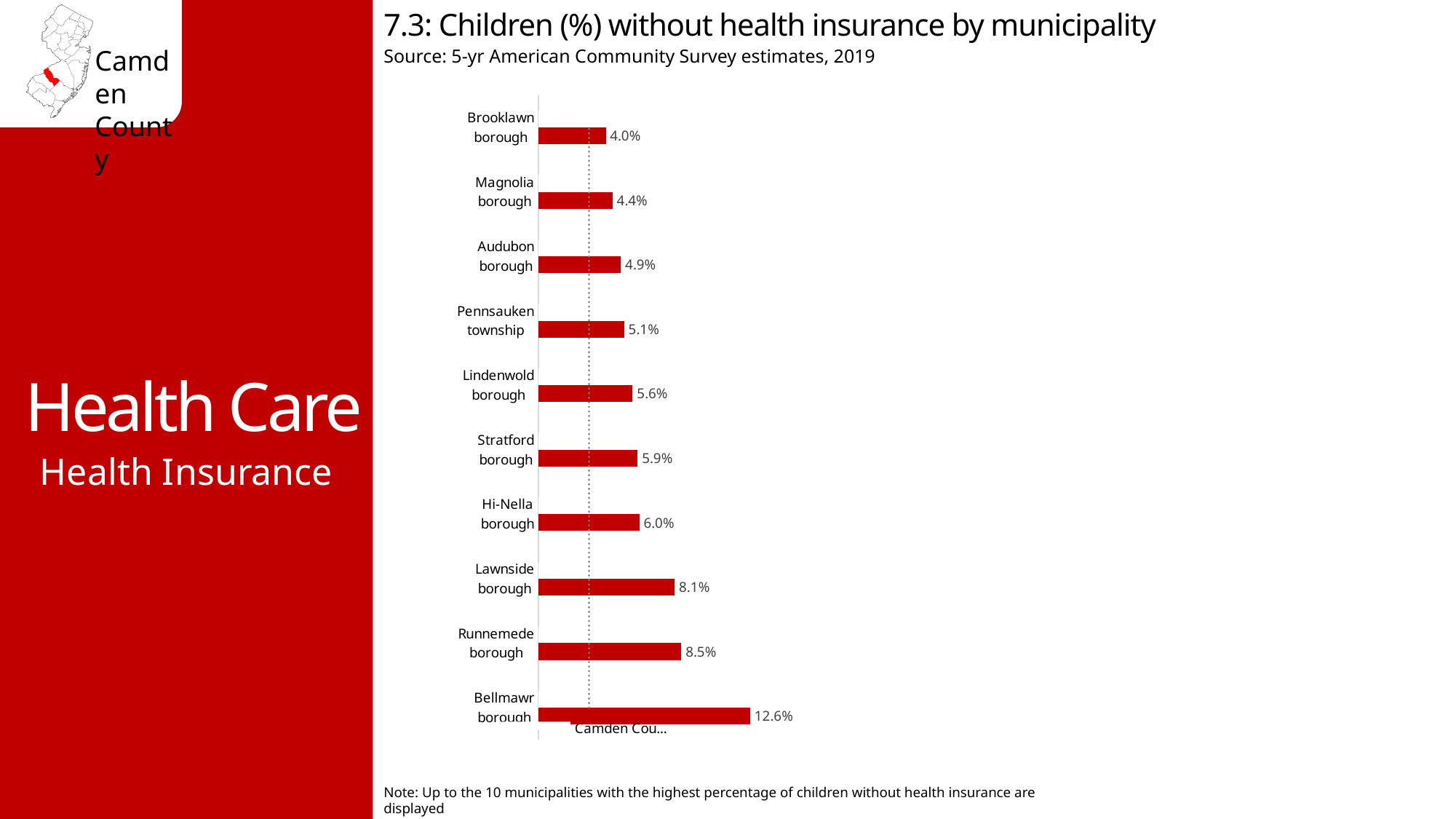
What is the title of the chart? 7.3: Children (%) without health insurance by municipality What is the difference between the values for Bellmawr borough and Runnemede borough? 4.1% Which has a higher value, Lindenwold borough or Audubon borough? Lindenwold borough How many municipalities are shown in the chart? 10 What is the difference between the values for Hi-Nella borough and Brooklawn borough? 2.0% Which municipality has the highest percentage of children without health insurance? Bellmawr borough Which has a higher value, Magnolia borough or Stratford borough? Stratford borough What is the value shown for Lawnside borough? 8.1% Which municipality has the lowest percentage of children without health insurance? Brooklawn borough What is the value shown for Pennsauken township? 5.1% What percentage of children are without health insurance in Bellmawr borough? 12.6% What kind of chart is shown on the slide? Bar chart